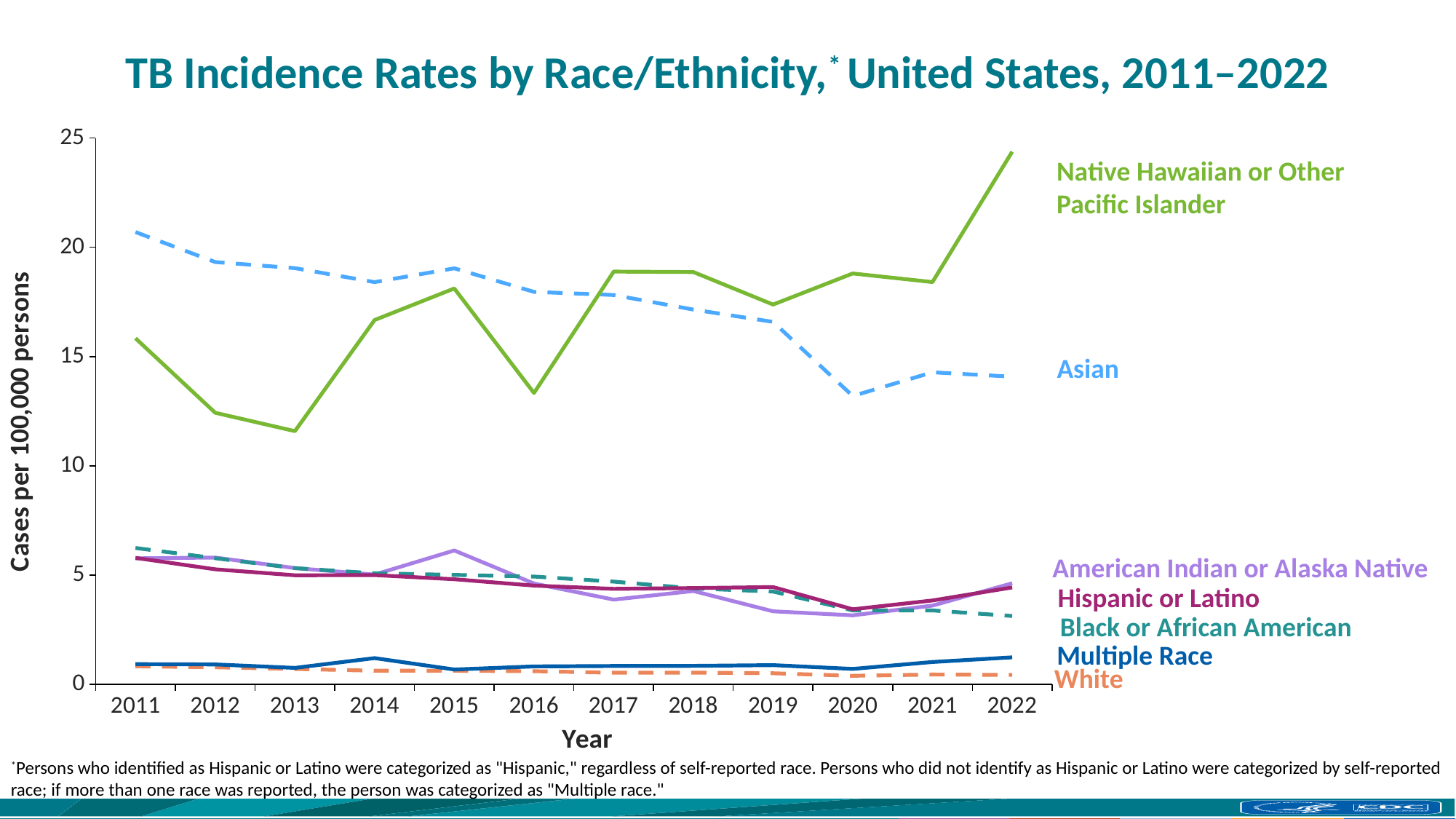
Is the value for White in 2022 greater or less than 5? less What is the label on the y axis? Cases per 100,000 persons Which group has the highest TB incidence rate in 2011? Asian Which group has the highest TB incidence rate in 2022? Native Hawaiian or Other Pacific Islander Is the value for Native Hawaiian or Other Pacific Islander in 2022 greater or less than 20? greater In 2016, which is larger: the rate for Asian or the rate for Native Hawaiian or Other Pacific Islander? Asian How many years are shown along the x axis? 12 Does the Asian line overall rise or fall from 2011 to 2022? Fall How many race/ethnicity groups (series) are plotted on the chart? 7 Is the value for Asian in 2020 greater or less than 15? less Which group has the lowest TB incidence rate in 2022? White What kind of chart is shown on the slide? Line chart